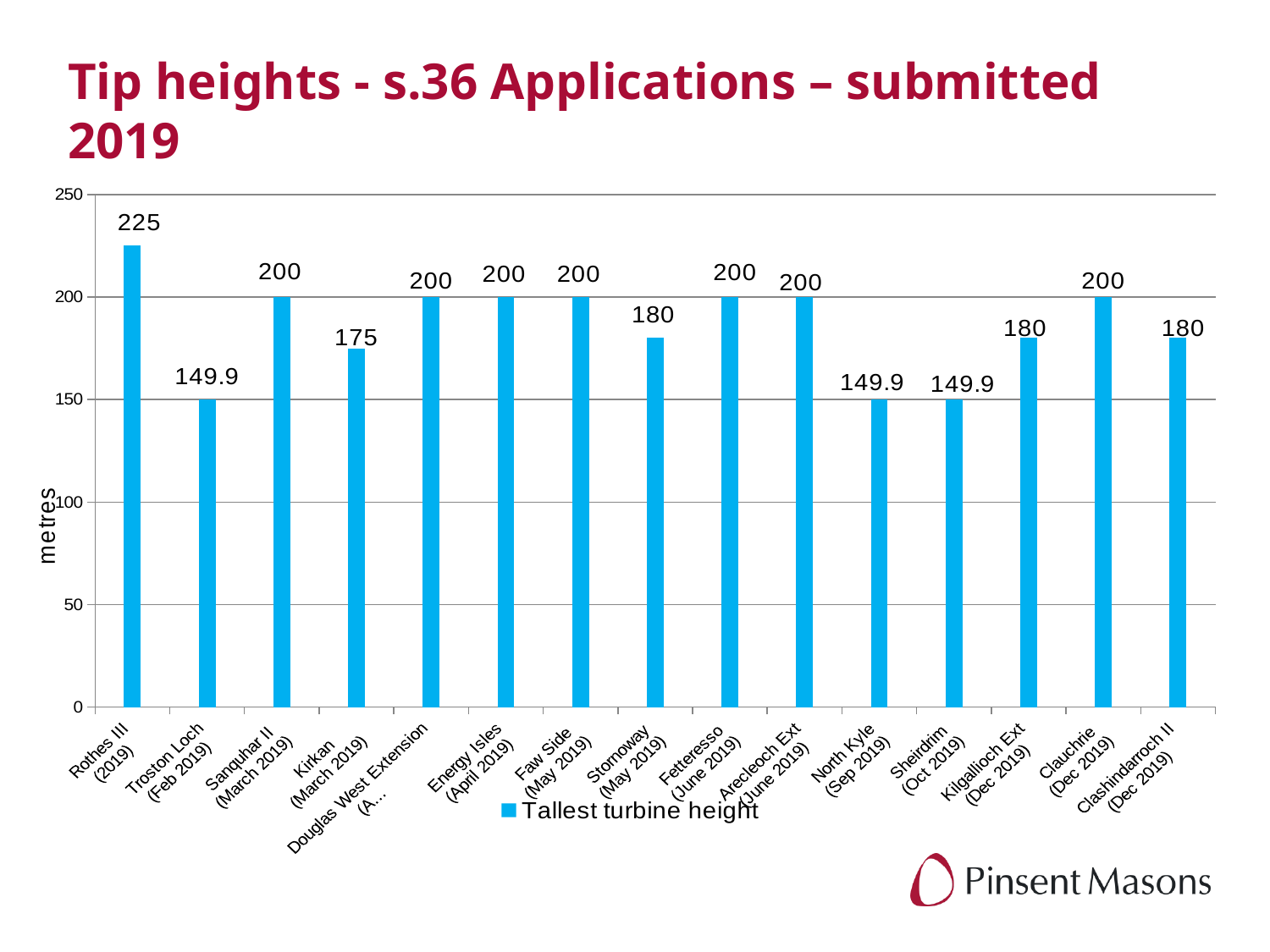
What type of chart is shown on the slide? Bar chart What is the difference between the tallest turbine height for Rothes III (2019) and Kirkan (March 2019)? 50 Which project has the highest tallest turbine height? Rothes III (2019) Is the value for Sheirdrim (Oct 2019) greater or less than 200? less What is the tallest turbine height for Troston Loch (Feb 2019)? 149.9 How many projects are shown on the chart? 15 What is the tallest turbine height for Kirkan (March 2019)? 175 What is the tallest turbine height for Stornoway (May 2019)? 180 Which has a greater tallest turbine height, Clauchrie (Dec 2019) or Clashindarroch II (Dec 2019)? Clauchrie (Dec 2019) What is the lowest tallest turbine height shown on the chart? 149.9 How many series does the legend list? 1 What is the tallest turbine height for Rothes III (2019)? 225